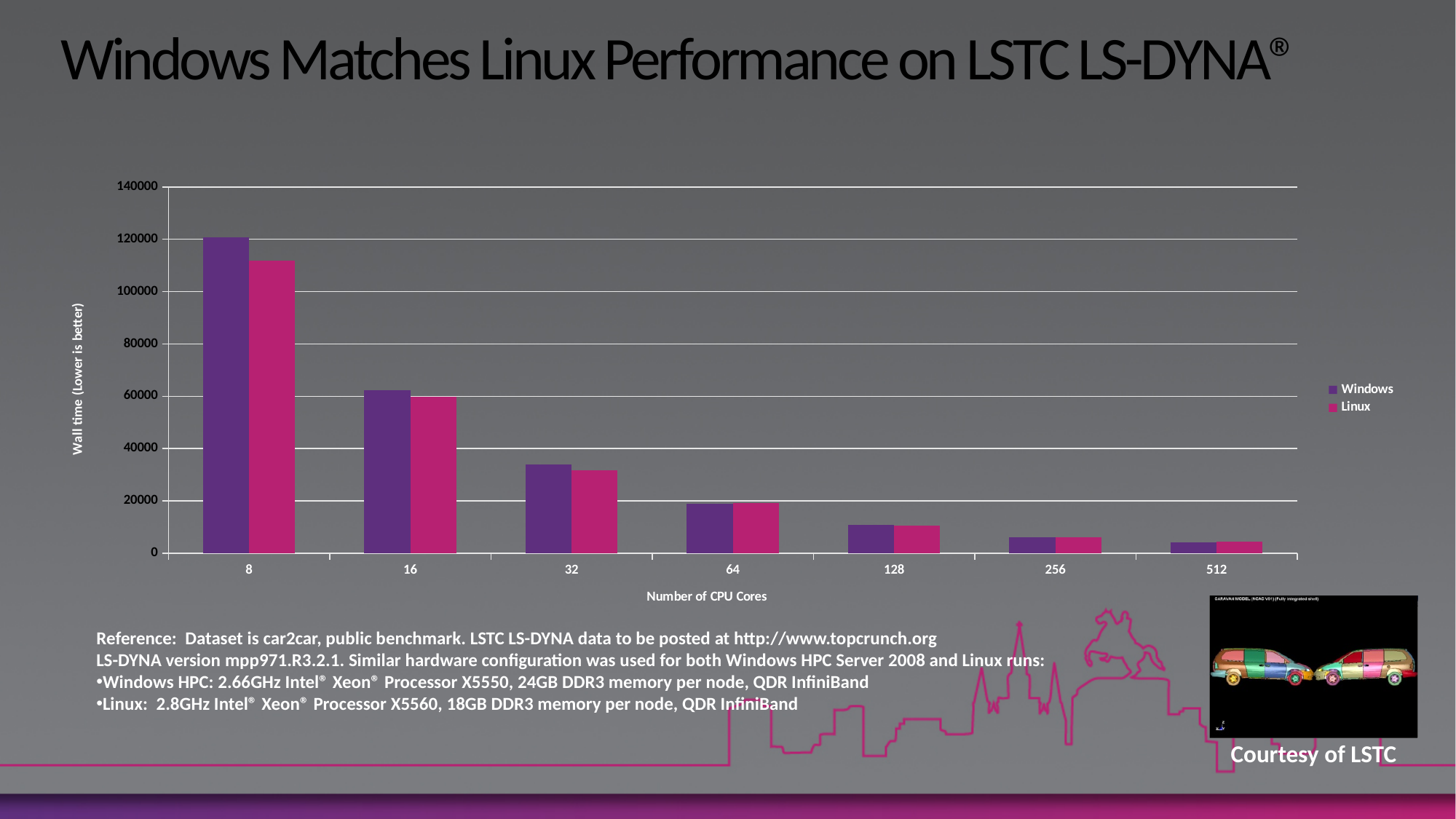
At which number of CPU cores is the Windows wall time highest? 8 At 8 CPU cores, which has the larger wall time, Windows or Linux? Windows At which number of CPU cores is the Linux wall time lowest? 512 Is the Linux wall time at 8 cores greater or less than 120000? less Is the Windows wall time at 8 cores greater or less than 100000? greater How many series does the legend list? 2 What is the title of the x axis? Number of CPU Cores How many CPU core counts are shown along the x axis? 7 Do the wall times rise or fall as the number of CPU cores increases? fall Is the Windows wall time at 16 cores greater or less than 80000? less What kind of chart is shown on the slide? bar chart